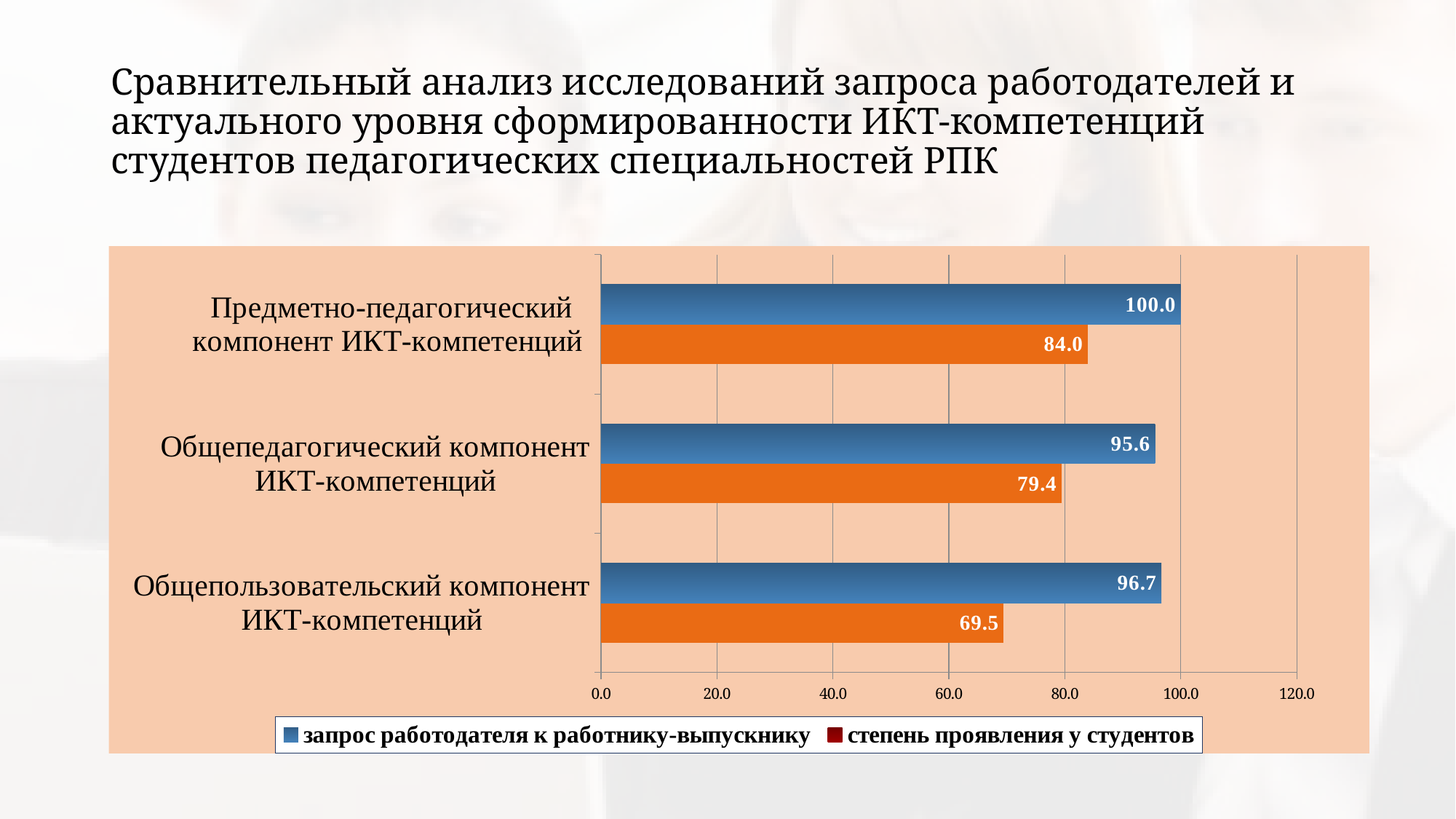
What is the difference between «запрос работодателя к работнику-выпускнику» and «степень проявления у студентов» for «Предметно-педагогический компонент ИКТ-компетенций»? 16.0 What is the value of «запрос работодателя к работнику-выпускнику» for «Предметно-педагогический компонент ИКТ-компетенций»? 100.0 Which is larger: «степень проявления у студентов» for «Предметно-педагогический компонент ИКТ-компетенций» or for «Общепедагогический компонент ИКТ-компетенций»? Предметно-педагогический компонент ИКТ-компетенций What is the value of «степень проявления у студентов» for «Общепользовательский компонент ИКТ-компетенций»? 69.5 Which category has the highest value for «запрос работодателя к работнику-выпускнику»? Предметно-педагогический компонент ИКТ-компетенций Which category has the lowest value for «степень проявления у студентов»? Общепользовательский компонент ИКТ-компетенций What is the value of «степень проявления у студентов» for «Общепедагогический компонент ИКТ-компетенций»? 79.4 What is the difference between «запрос работодателя к работнику-выпускнику» and «степень проявления у студентов» for «Общепользовательский компонент ИКТ-компетенций»? 27.2 What is the value of «запрос работодателя к работнику-выпускнику» for «Общепедагогический компонент ИКТ-компетенций»? 95.6 What kind of chart is shown on the slide? Bar chart How many series does the legend list? 2 How many categories are shown on the chart? 3